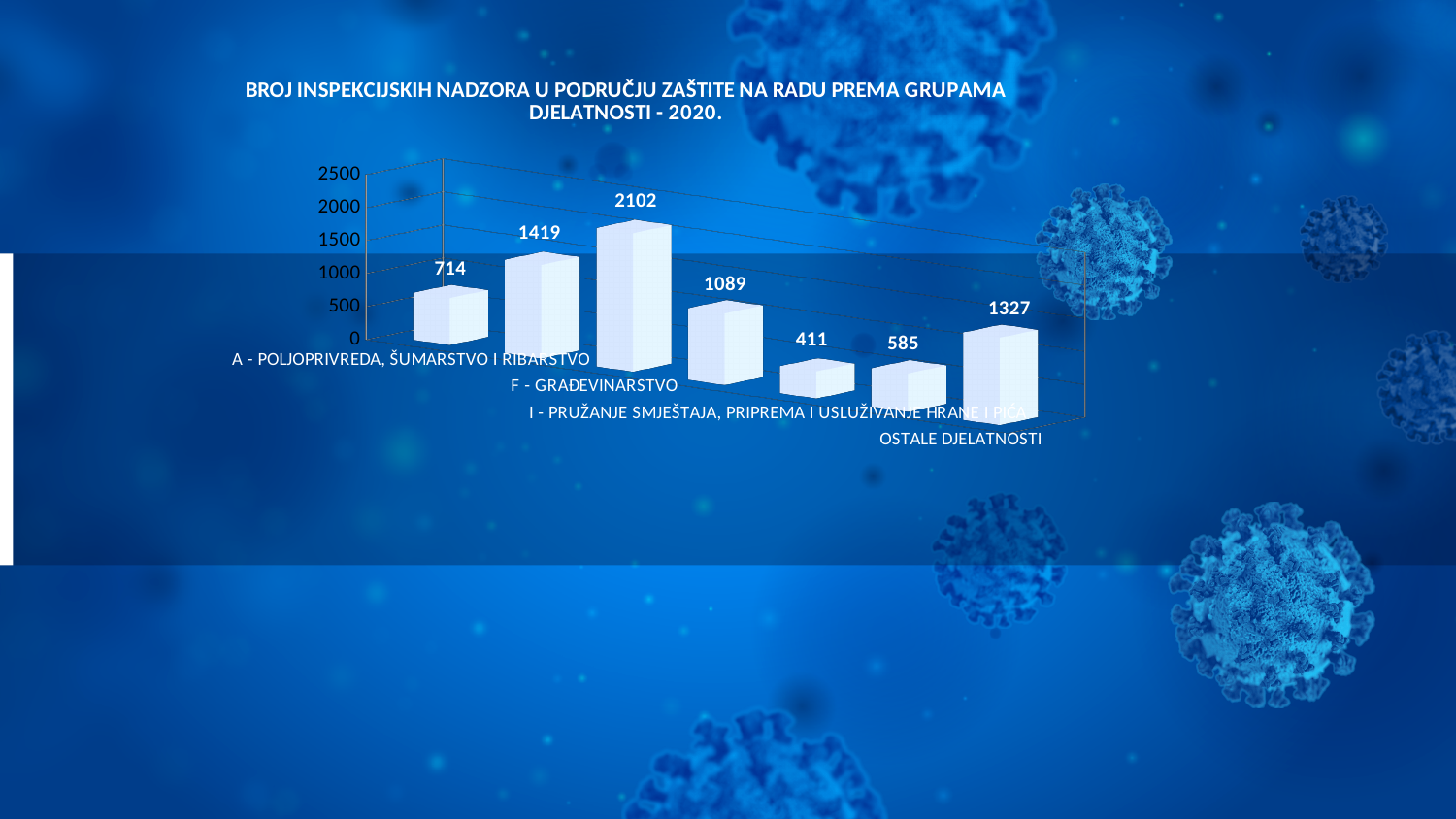
What is the highest value shown on the chart? 2102 What kind of chart is shown on the slide? Bar chart What is the lowest value shown on the chart? 411 What is the difference between the values for F - GRAĐEVINARSTVO and A - POLJOPRIVREDA, ŠUMARSTVO I RIBARSTVO? 1388 What is the number of inspections for F - GRAĐEVINARSTVO? 2102 What is the number of inspections for OSTALE DJELATNOSTI? 1327 Which labelled category has the highest number of inspections? F - GRAĐEVINARSTVO What is the number of inspections for A - POLJOPRIVREDA, ŠUMARSTVO I RIBARSTVO? 714 What is the number of inspections for I - PRUŽANJE SMJEŠTAJA, PRIPREMA I USLUŽIVANJE HRANE I PIĆA? 411 How many bars are shown on the chart? 7 What is the difference between the values for OSTALE DJELATNOSTI and I - PRUŽANJE SMJEŠTAJA, PRIPREMA I USLUŽIVANJE HRANE I PIĆA? 916 Which is larger, the value for A - POLJOPRIVREDA, ŠUMARSTVO I RIBARSTVO or the value for OSTALE DJELATNOSTI? OSTALE DJELATNOSTI